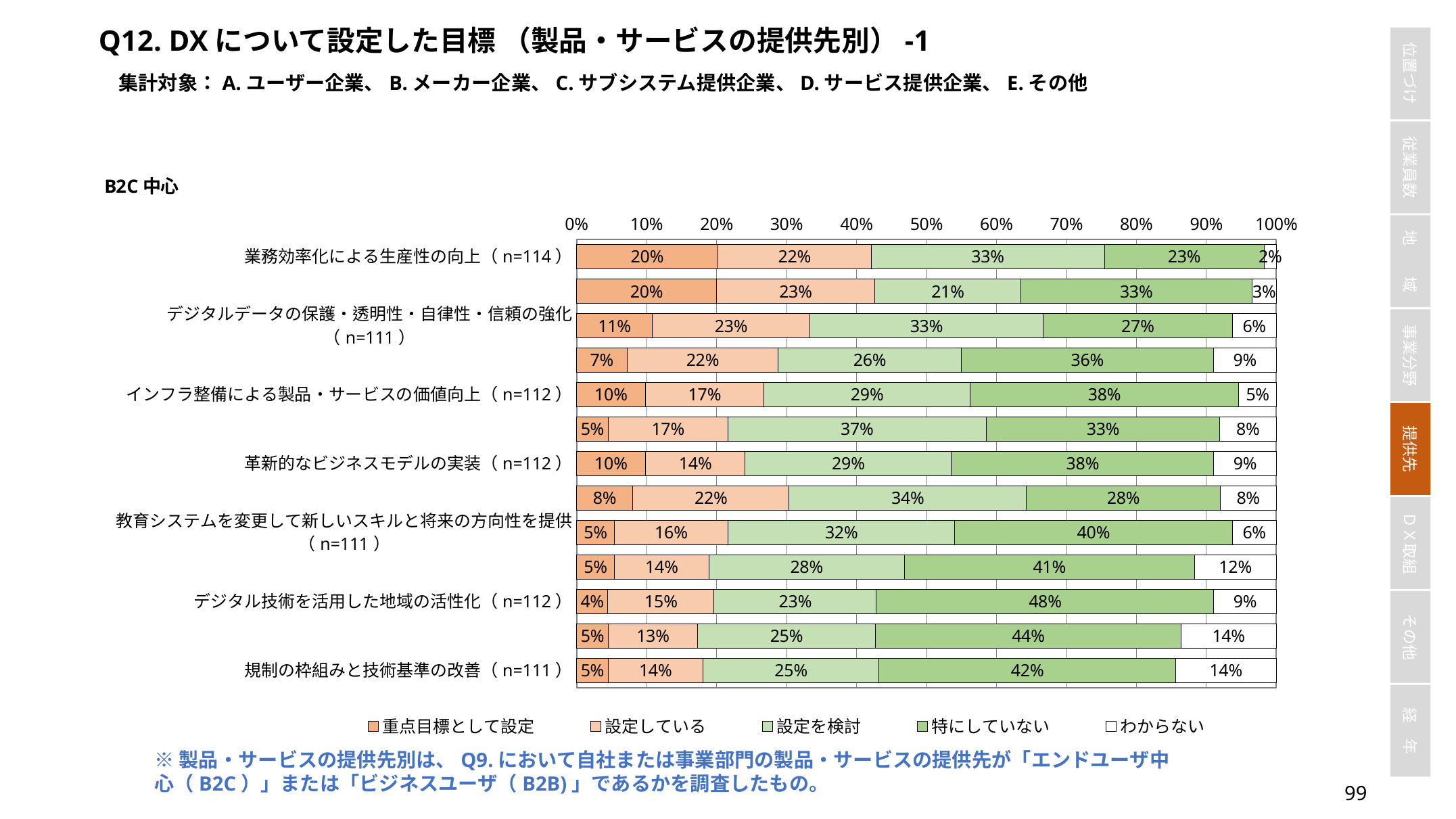
Among the labeled categories, which has the highest 重点目標として設定 share? 業務効率化による生産性の向上（n=114） How many series does the legend list? 5 Which legend entry is shown in the darkest green? 特にしていない What percentage of respondents chose わからない for 規制の枠組みと技術基準の改善（n=111）? 14% Which is larger: the 設定を検討 share for 業務効率化による生産性の向上（n=114） or for 革新的なビジネスモデルの実装（n=112）? 業務効率化による生産性の向上（n=114） What percentage of respondents chose 重点目標として設定 for 業務効率化による生産性の向上（n=114）? 20% What is the total of the stacked bar for 業務効率化による生産性の向上（n=114）? 100% What percentage of respondents chose 特にしていない for デジタル技術を活用した地域の活性化（n=112）? 48% What is the difference between the 特にしていない share for デジタル技術を活用した地域の活性化（n=112） and for 業務効率化による生産性の向上（n=114）? 25% What percentage of respondents chose 設定している for インフラ整備による製品・サービスの価値向上（n=112）? 17% What percentage of respondents chose 設定を検討 for 教育システムを変更して新しいスキルと将来の方向性を提供（n=111）? 32% What kind of chart is shown on the slide? Stacked bar chart